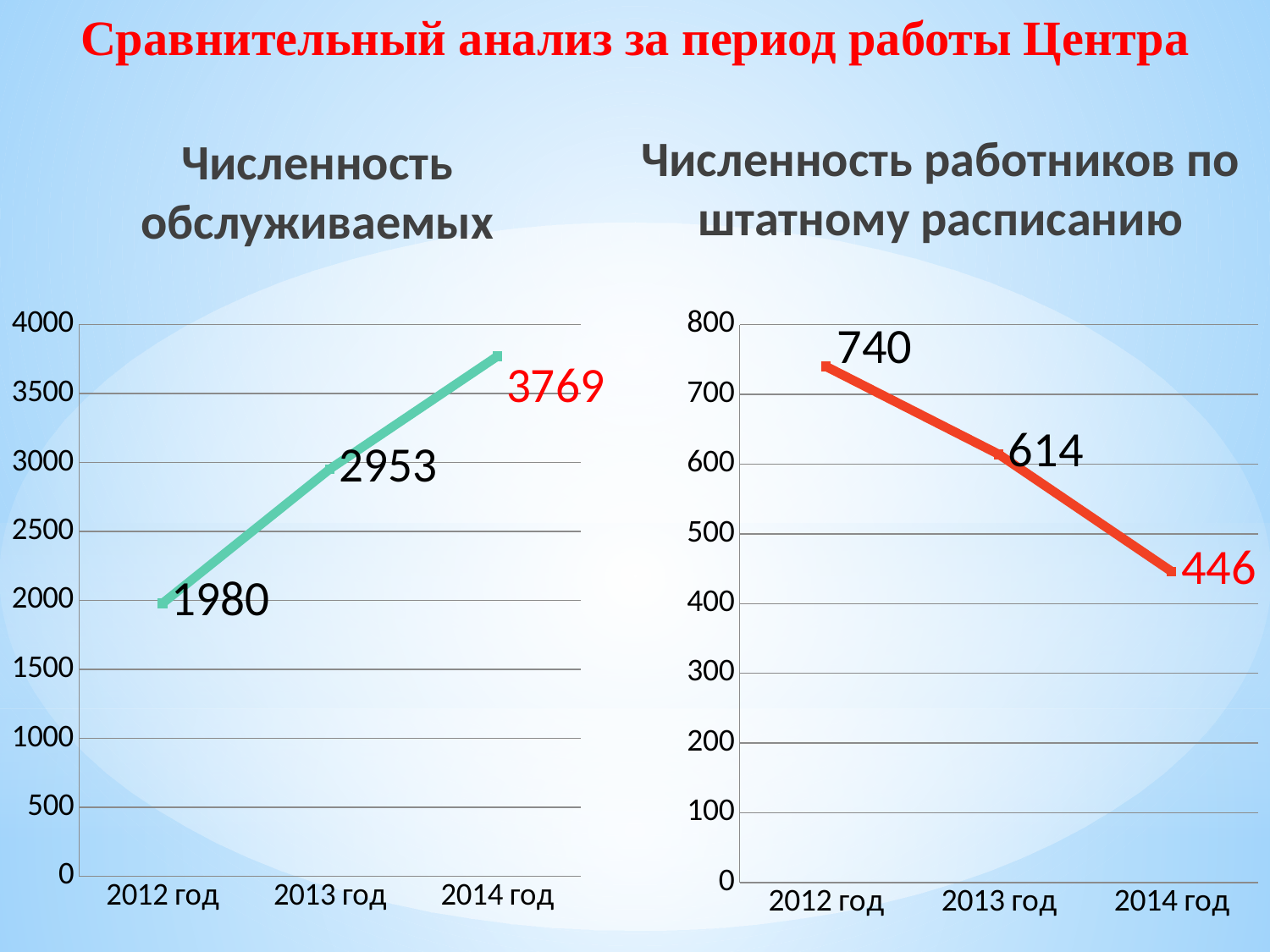
In the chart titled "Численность обслуживаемых", do the values rise or fall from 2012 год to 2014 год? rise In the chart titled "Численность работников по штатному расписанию", is the value for 2012 год greater or less than 700? greater In the chart titled "Численность работников по штатному расписанию", do the values rise or fall from 2012 год to 2014 год? fall What kind of chart is the chart titled "Численность обслуживаемых"? line chart In the chart titled "Численность обслуживаемых", what is the difference between the values for 2014 год and 2012 год? 1789 In the chart titled "Численность работников по штатному расписанию", what is the difference between the values for 2012 год and 2014 год? 294 In the chart titled "Численность обслуживаемых", what is the value for 2014 год? 3769 In the chart titled "Численность обслуживаемых", which year has the highest value? 2014 год In the chart titled "Численность работников по штатному расписанию", what is the value for 2014 год? 446 In the chart titled "Численность обслуживаемых", what is the value for 2012 год? 1980 In the chart titled "Численность работников по штатному расписанию", which year has the lowest value? 2014 год In the chart titled "Численность работников по штатному расписанию", what is the value for 2013 год? 614